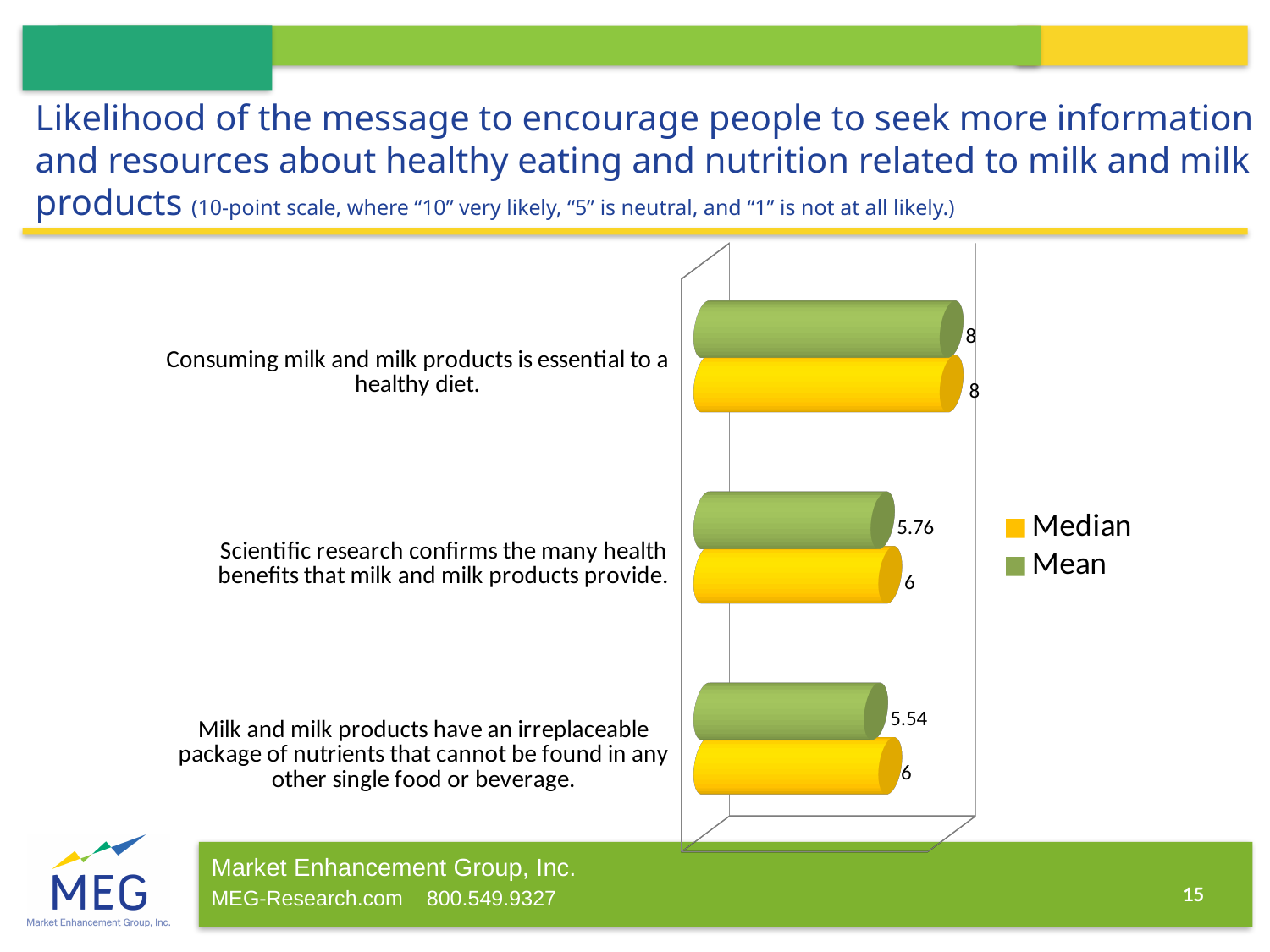
What is the Mean value for "Milk and milk products have an irreplaceable package of nutrients that cannot be found in any other single food or beverage."? 5.54 Which colour represents the Median series in the chart? Yellow Which is larger: the Median or the Mean for "Scientific research confirms the many health benefits that milk and milk products provide."? Median What is the Median value for "Scientific research confirms the many health benefits that milk and milk products provide."? 6 What is the Mean value for "Consuming milk and milk products is essential to a healthy diet."? 8 What kind of chart is shown on the slide? Bar chart What is the Mean value for "Scientific research confirms the many health benefits that milk and milk products provide."? 5.76 Which message has the lowest Mean value? Milk and milk products have an irreplaceable package of nutrients that cannot be found in any other single food or beverage. How many messages (categories) are shown in the chart? 3 Which message has the highest Mean value? Consuming milk and milk products is essential to a healthy diet. What is the difference between the Mean values for "Scientific research confirms the many health benefits..." and "Milk and milk products have an irreplaceable package of nutrients..."? 0.22 How many series does the legend list? 2